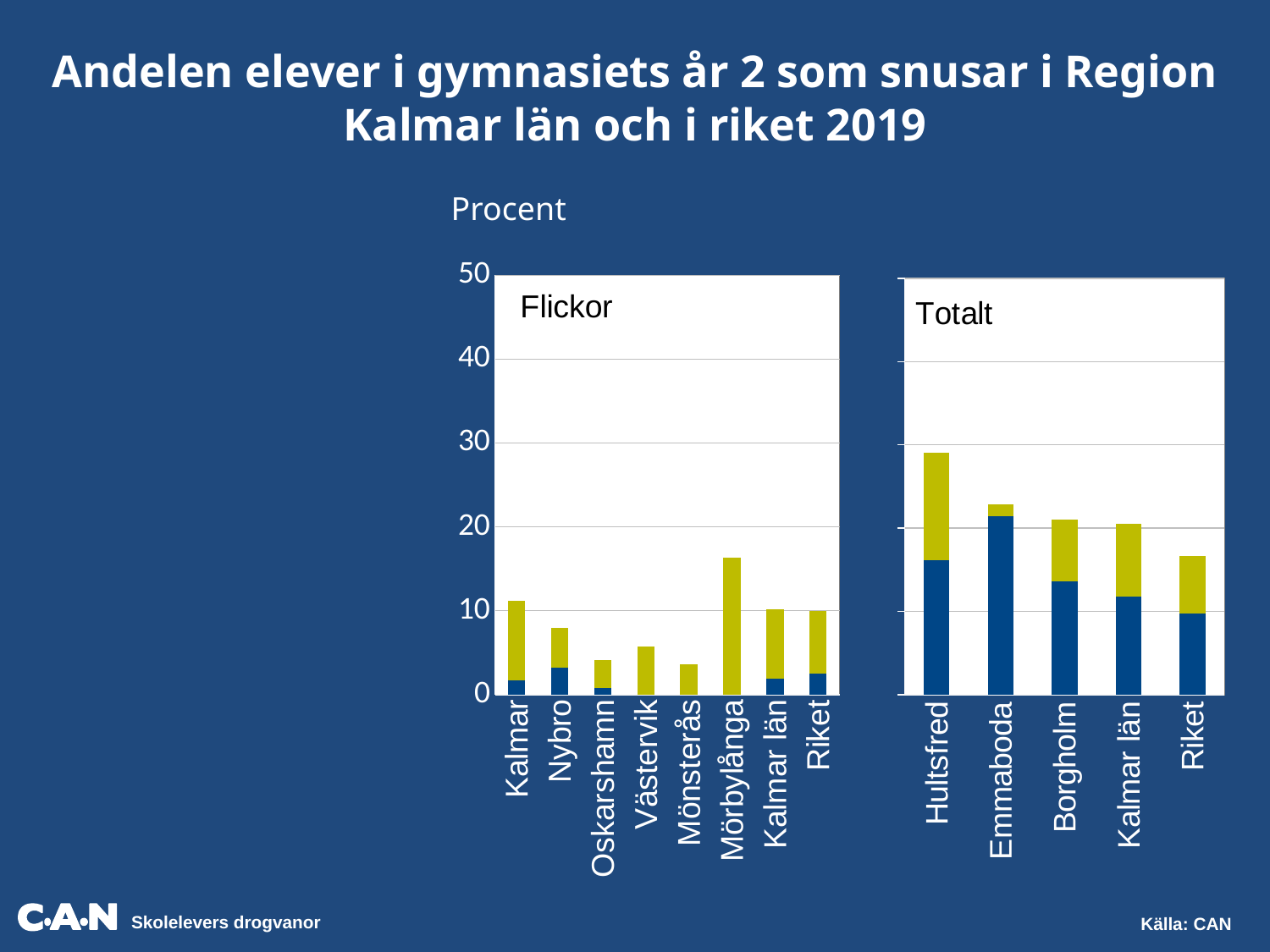
In the "Flickor" chart, which category has the highest bar? Mörbylånga How many categories are shown on the x axis of the "Totalt" chart? 5 In the "Flickor" chart, is the value for Nybro greater or less than 10? less How many categories are shown on the x axis of the "Flickor" chart? 8 In the "Totalt" chart, is the value for Hultsfred greater or less than 20? greater What unit label is shown above the y axis of the charts? Procent In the "Totalt" chart, is the value for Riket greater or less than 20? less What kind of chart is the "Flickor" chart? bar chart In the "Flickor" chart, which is larger, the value for Mörbylånga or the value for Nybro? Mörbylånga In the "Totalt" chart, which category has the highest bar? Hultsfred In the "Totalt" chart, which category has the lowest bar? Riket